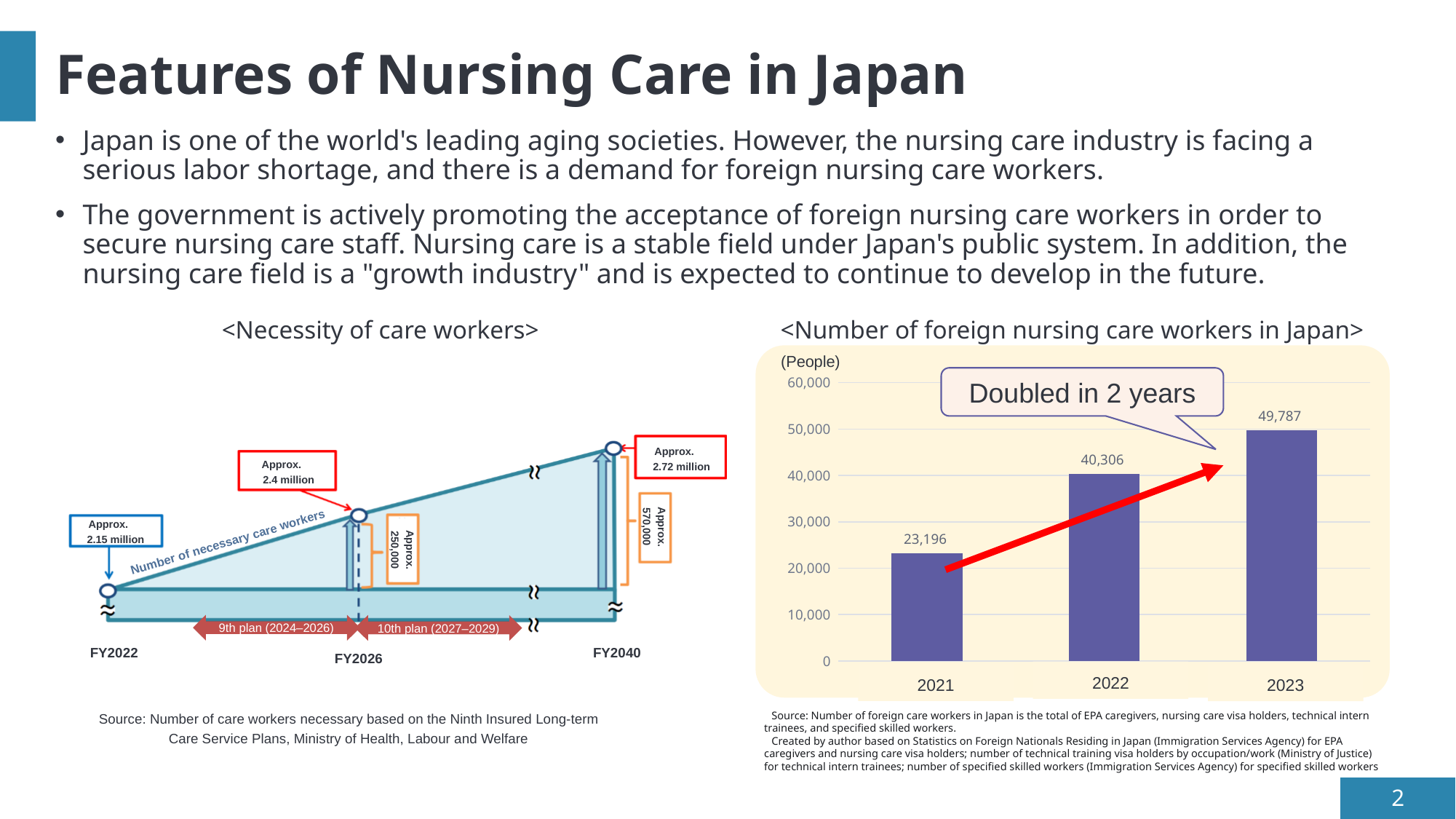
In the chart titled <Number of foreign nursing care workers in Japan>, how many years are plotted? 3 What kind of chart is the one titled <Number of foreign nursing care workers in Japan>? bar chart In the chart titled <Number of foreign nursing care workers in Japan>, what is the difference between the 2022 and 2021 values? 17,110 In the diagram titled <Necessity of care workers>, what is the approximate number of necessary care workers shown for FY2040? Approx. 2.72 million In the chart titled <Number of foreign nursing care workers in Japan>, what is the value for 2022? 40,306 In the chart titled <Number of foreign nursing care workers in Japan>, what is the value for 2021? 23,196 In the chart titled <Number of foreign nursing care workers in Japan>, which year has the lowest value? 2021 In the chart titled <Number of foreign nursing care workers in Japan>, do the values rise or fall from 2021 to 2023? rise In the chart titled <Number of foreign nursing care workers in Japan>, which year has the highest value? 2023 In the chart titled <Number of foreign nursing care workers in Japan>, what is the value for 2023? 49,787 In the chart titled <Number of foreign nursing care workers in Japan>, what is the difference between the 2023 and 2022 values? 9,481 In the chart titled <Number of foreign nursing care workers in Japan>, what does the callout above the bars say? Doubled in 2 years